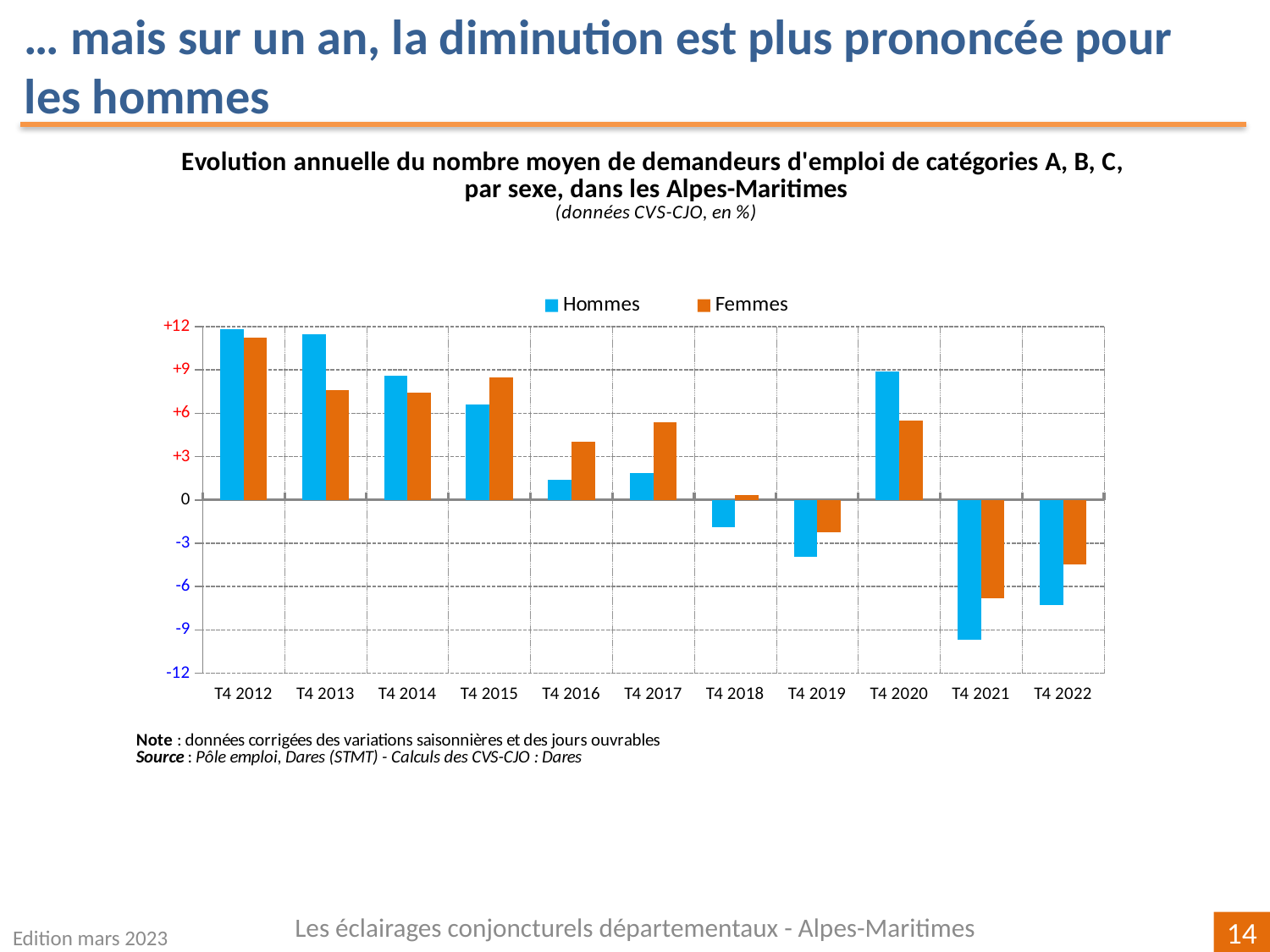
For T4 2017, which series has the larger value, Hommes or Femmes? Femmes Is the Hommes value for T4 2021 greater or less than -6? less Is the Hommes value for T4 2020 greater or less than +6? greater Do the Hommes values rise or fall from T4 2012 to T4 2016? fall In which quarter is the Femmes value lowest? T4 2021 How many series does the legend list? 2 What kind of chart is shown on the slide? bar chart How many quarters (categories) are shown on the x axis? 11 In which quarter is the Hommes value lowest? T4 2021 Is the Femmes value for T4 2016 greater or less than +3? greater Which colour represents the Femmes series? orange In which quarter is the Femmes value highest? T4 2012